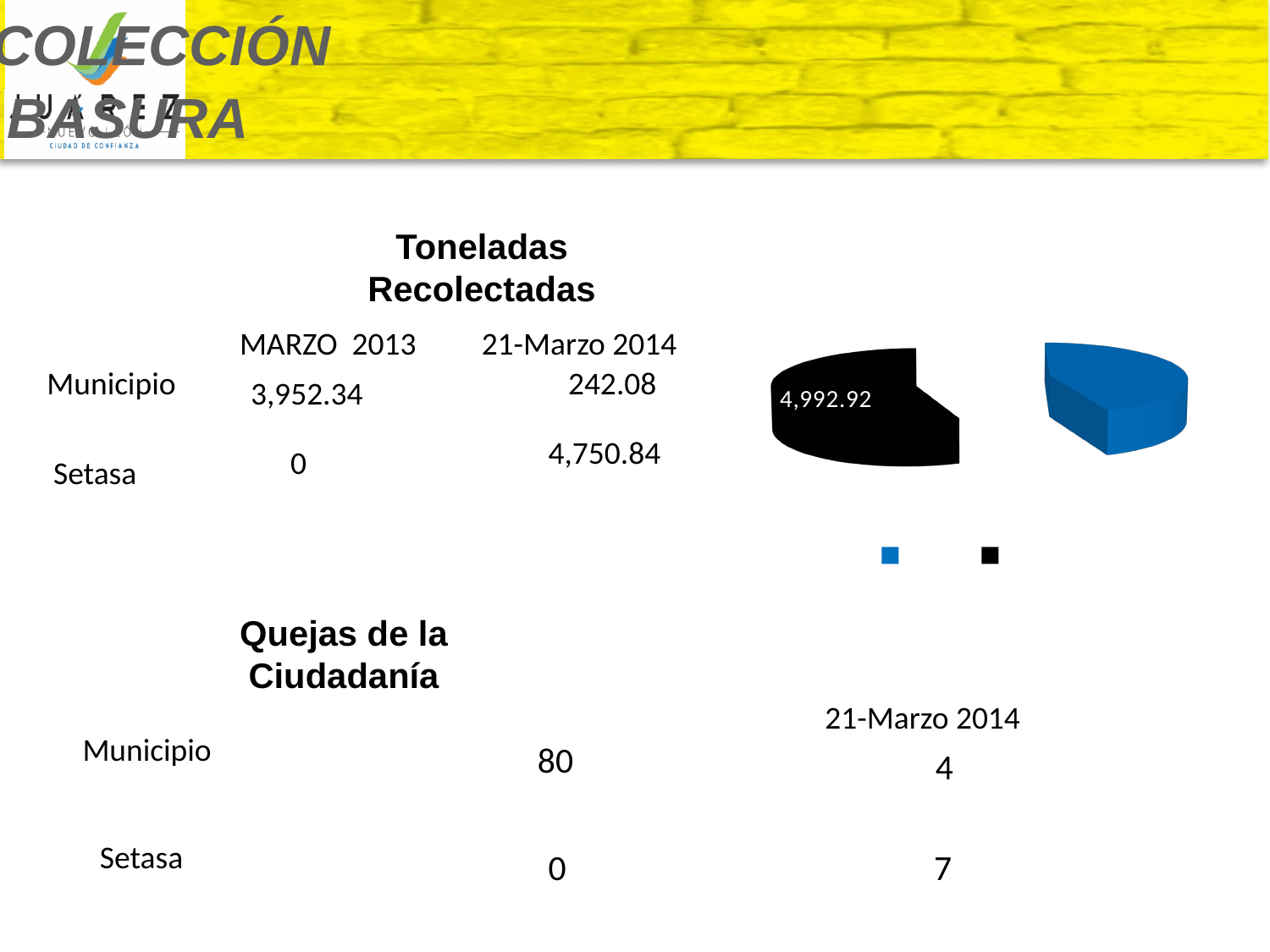
Which slice of the pie chart is the smallest? the blue slice In the pie chart, is the black slice or the blue slice larger? the black slice What two colours are used for the slices of the pie chart? black and blue How many entries does the legend below the pie chart show? 2 What value is printed on the black slice of the pie chart? 4,992.92 What kind of chart is shown on the right side of the slide? pie chart How many slices does the pie chart on the right have? 2 Which slice of the pie chart is the largest? the black slice